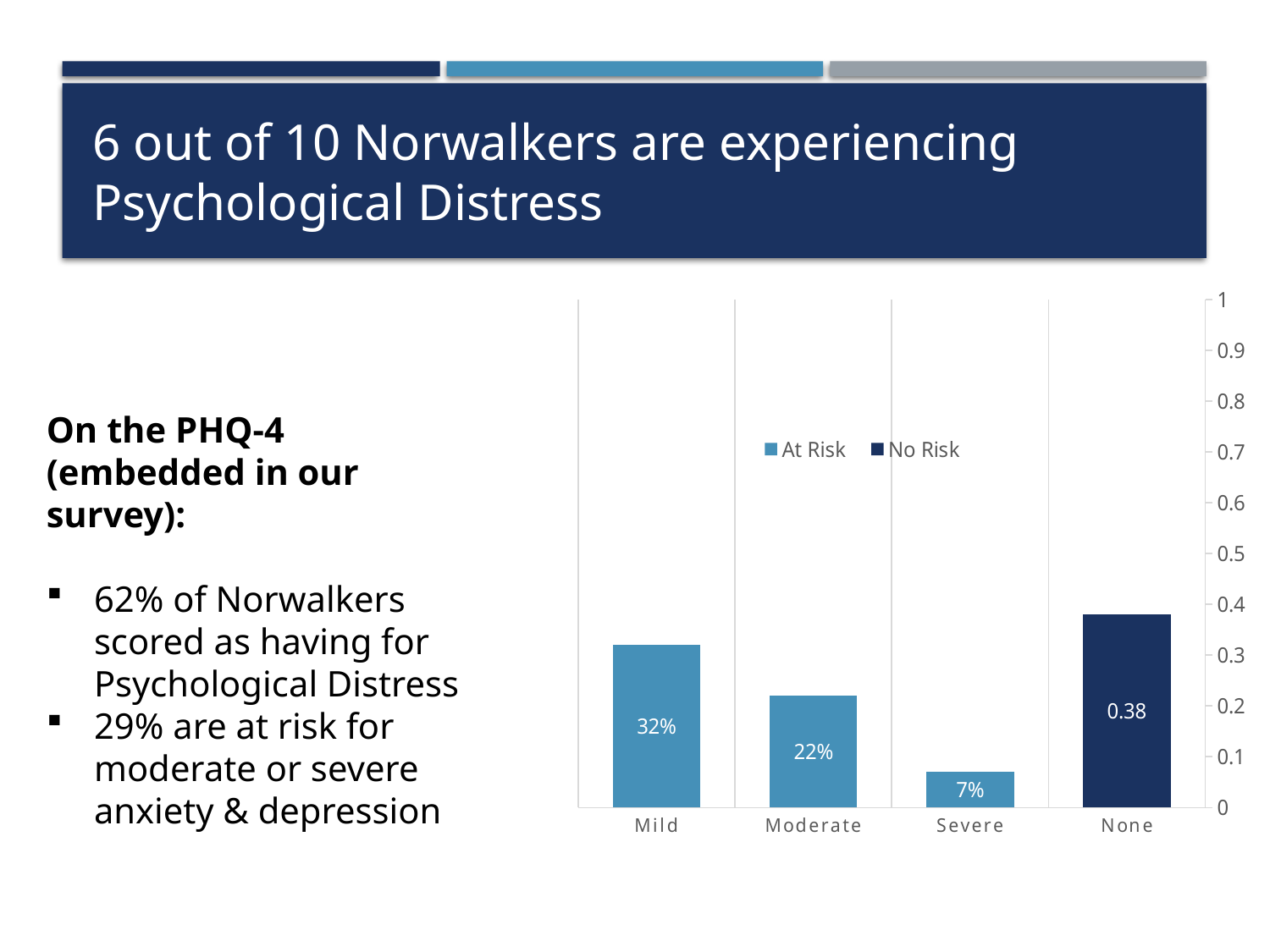
What is the value for Moderate? 22% Which category has the lowest value? Severe How many categories are shown on the x axis? 4 What is the difference between the values for Mild and Moderate? 10% Which category has the highest value? None What is the value for None? 0.38 Is the value for Mild greater or less than 0.4? less Which is larger, the value for Moderate or the value for Severe? Moderate What is the value for Severe? 7% What is the value for Mild? 32% How many series does the legend list? 2 What kind of chart is shown? bar chart